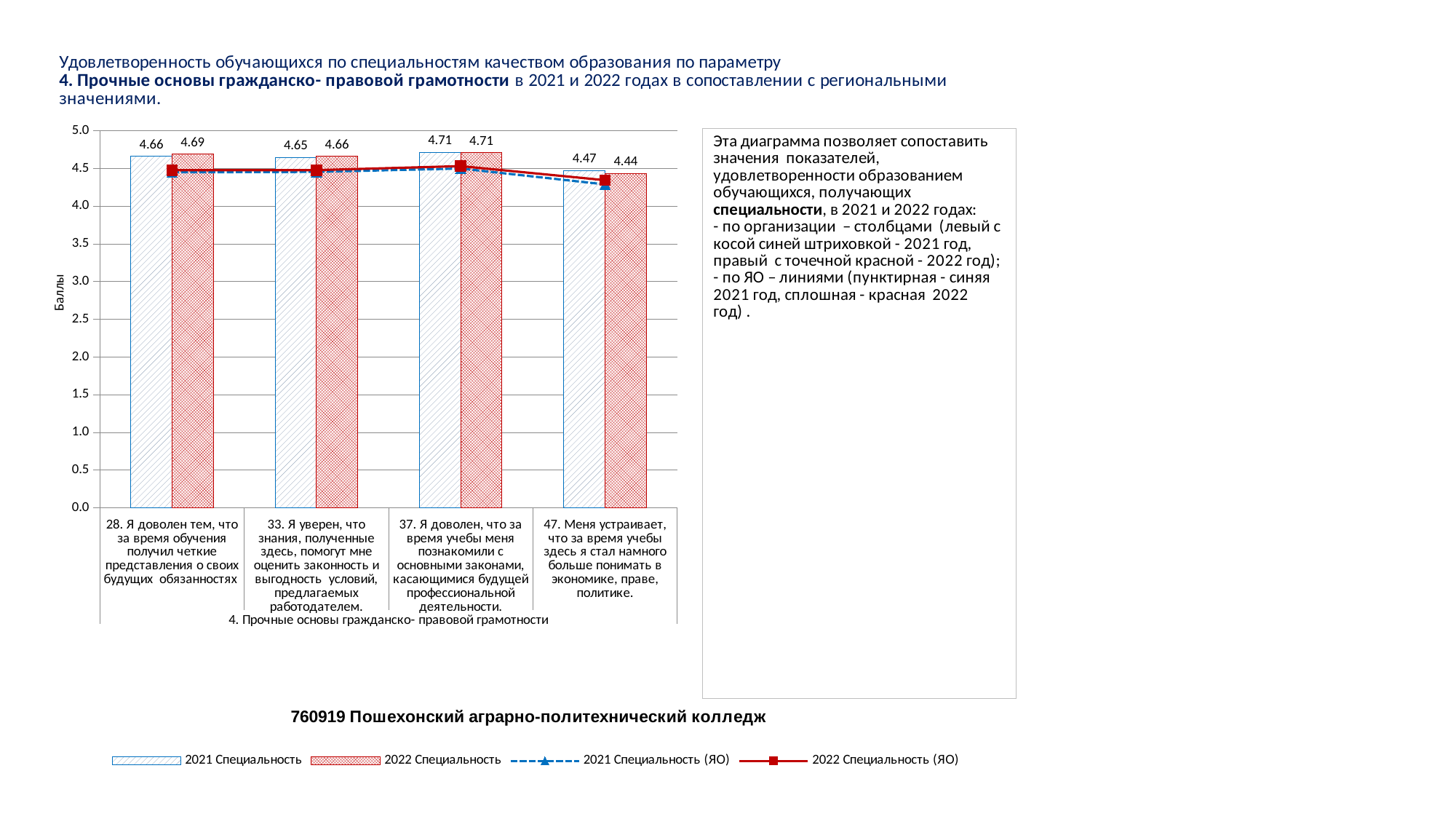
What is the value of the 2022 Специальность bar for item 33 (Я уверен, что знания, полученные здесь, помогут мне оценить законность и выгодность условий, предлагаемых работодателем)? 4.66 What is the label of the vertical axis? Баллы What is the value of the 2022 Специальность bar for item 47 (Меня устраивает, что за время учебы здесь я стал намного больше понимать в экономике, праве, политике)? 4.44 What is the value of the 2021 Специальность bar for item 28 (Я доволен тем, что за время обучения получил четкие представления о своих будущих обязанностях)? 4.66 How many series does the legend list? 4 How many survey items (categories) are shown on the x axis? 4 Which item has the lowest 2022 Специальность bar? 47. Меня устраивает, что за время учебы здесь я стал намного больше понимать в экономике, праве, политике. What is the difference between the 2022 and 2021 Специальность bars for item 28? 0.03 For item 47, which bar is larger: 2021 Специальность or 2022 Специальность? 2021 Специальность What kind of chart is shown on the slide? Combined bar and line chart Which item has the highest 2021 Специальность bar? 37. Я доволен, что за время учебы меня познакомили с основными законами, касающимися будущей профессиональной деятельности. Is the 2021 Специальность (ЯО) line value for item 47 greater or less than 4.5? less